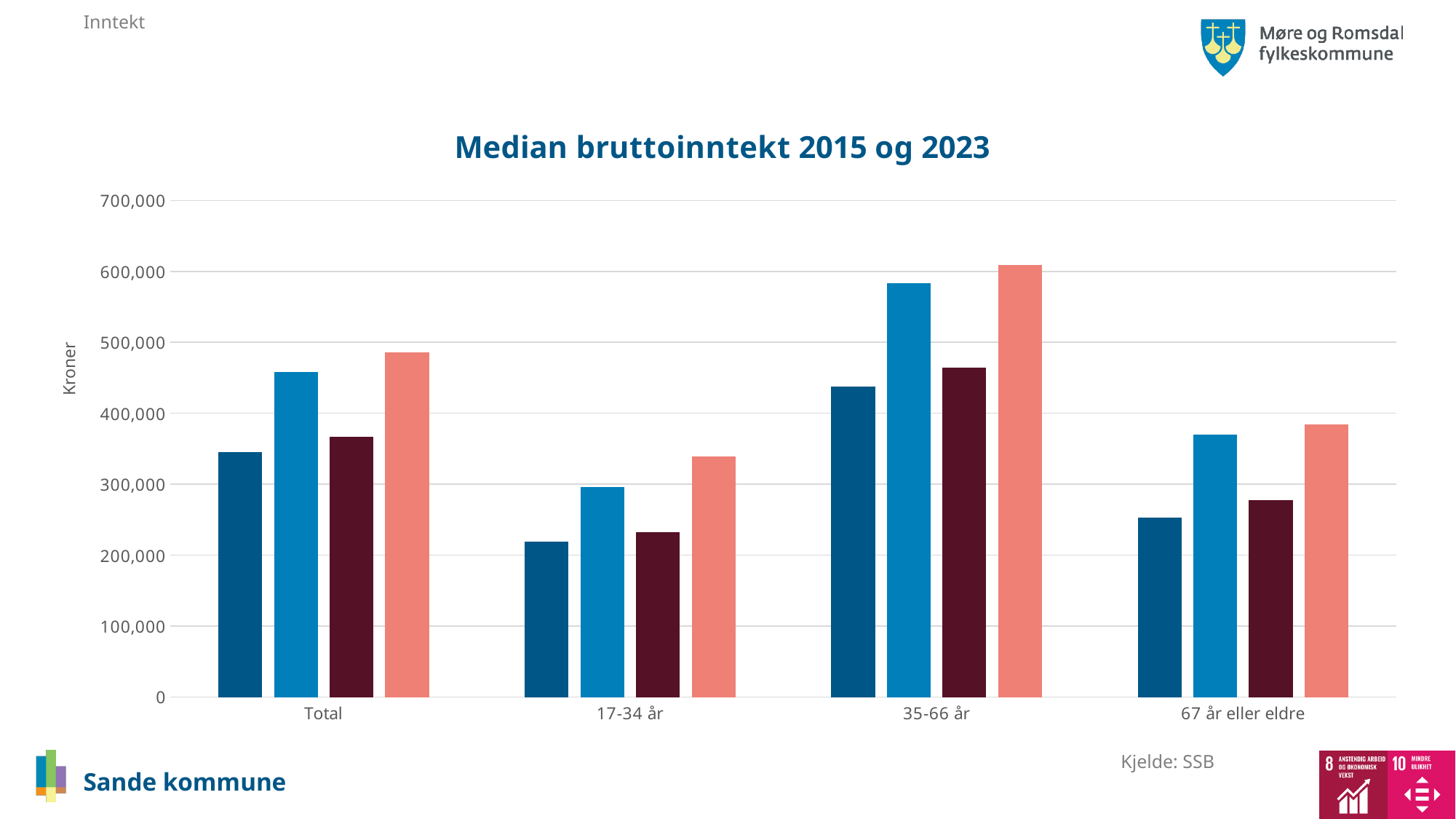
Which category has the tallest bars overall? 35-66 år Is the value of the dark blue bar for 17-34 år greater or less than 300,000? less Which is larger: the salmon-coloured bar for Total or the salmon-coloured bar for 67 år eller eldre? Total What is the label on the vertical axis of the chart? Kroner Is the value of the light blue bar for 35-66 år greater or less than 500,000? greater Is the value of the salmon-coloured bar for Total greater or less than 500,000? less Which category has the shortest bars overall? 17-34 år What kind of chart is shown on the slide? bar chart What is the title of the chart? Median bruttoinntekt 2015 og 2023 How many age categories are shown along the x axis? 4 How many bars are plotted for each category? 4